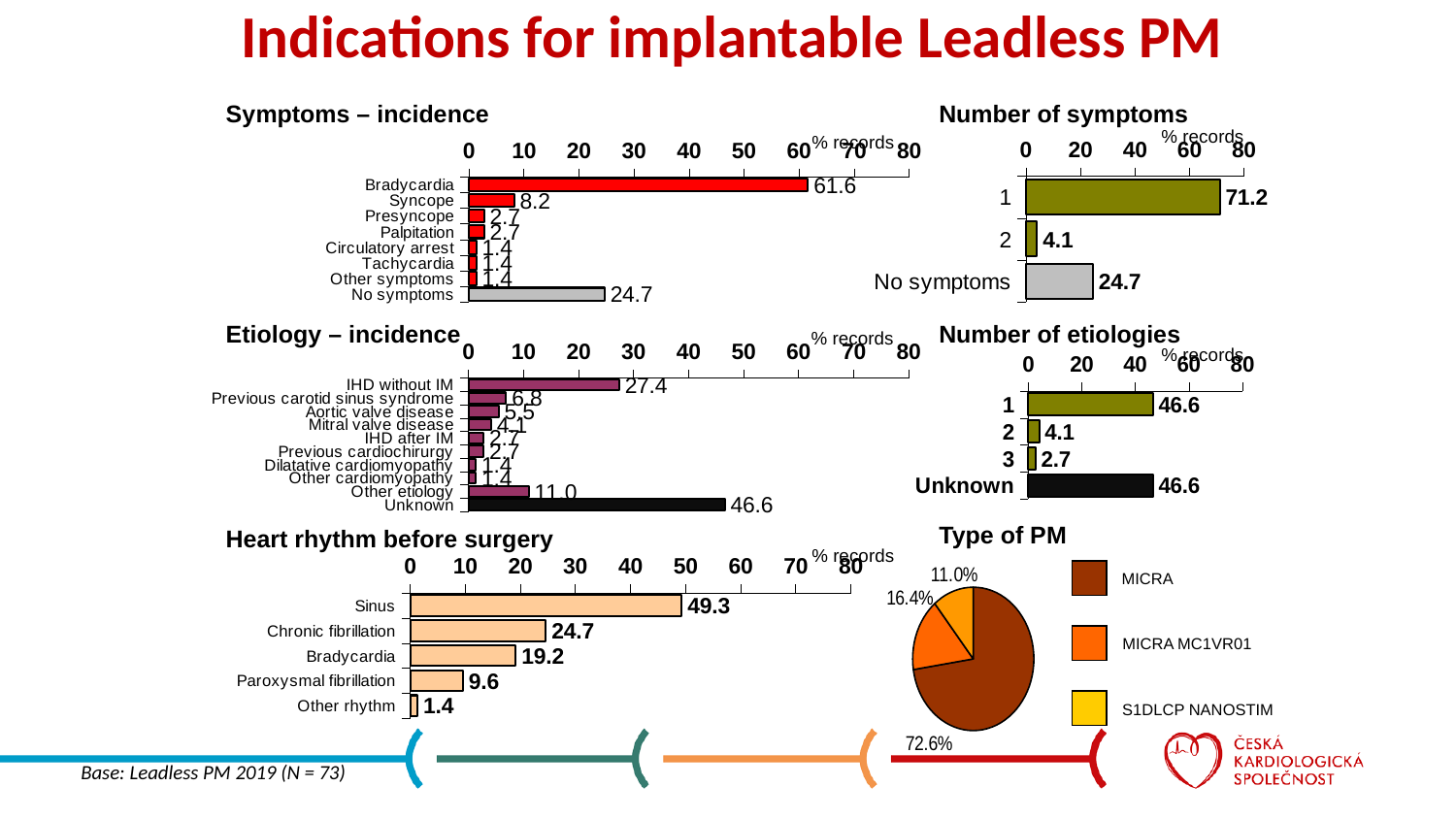
What kind of chart is the 'Type of PM' chart? Pie chart In the 'Number of symptoms' chart, what is the difference between the values for 1 symptom and No symptoms? 46.5 In the 'Heart rhythm before surgery' chart, what is the difference between Sinus and Chronic fibrillation? 24.6 In the 'Symptoms – incidence' chart, which symptom has the highest value? Bradycardia In the 'Heart rhythm before surgery' chart, which rhythm has the lowest value? Other rhythm In the 'Heart rhythm before surgery' chart, which is larger: Chronic fibrillation or Bradycardia? Chronic fibrillation In the 'Etiology – incidence' chart, what is the value for IHD without IM? 27.4 In the 'Type of PM' chart, what share does MICRA have? 72.6% In the 'Etiology – incidence' chart, how many categories are shown? 10 In the 'Symptoms – incidence' chart, what is the value for Bradycardia? 61.6 In the 'Number of etiologies' chart, what is the value for 3 etiologies? 2.7 In the 'Number of symptoms' chart, what is the value for 1 symptom? 71.2